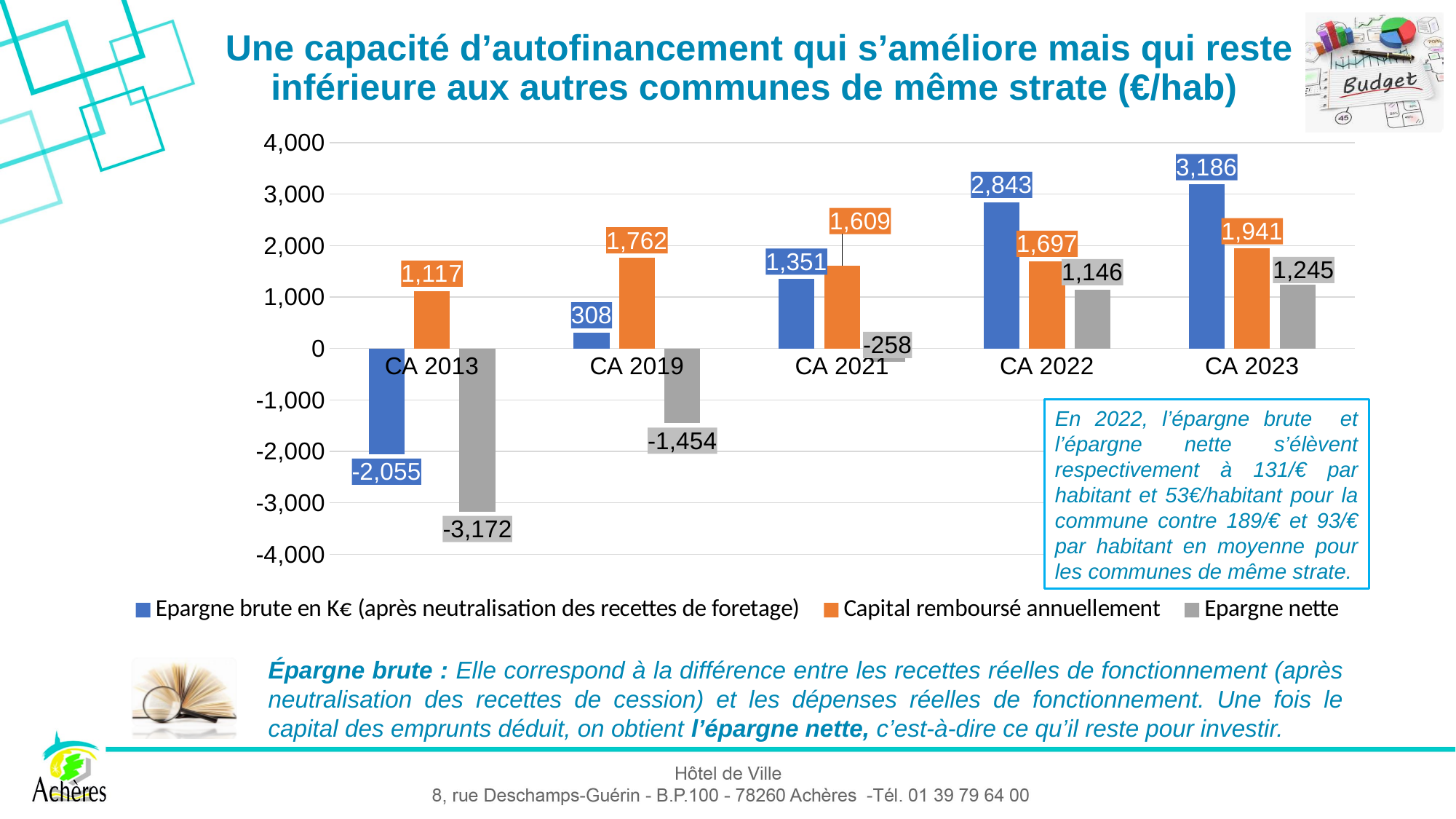
What is the value of Capital remboursé annuellement for CA 2019? 1,762 What kind of chart is shown on the slide? Bar chart Which is larger for CA 2021: Epargne brute en K€ or Capital remboursé annuellement? Capital remboursé annuellement What is the value of Epargne nette for CA 2021? -258 What is the difference between Epargne brute en K€ for CA 2023 and CA 2022? 343 How many series does the legend list? 3 What is the value of Epargne brute en K€ for CA 2023? 3,186 How many categories are shown on the x axis? 5 Which category has the lowest value for Epargne nette? CA 2013 Which category has the highest value for Epargne brute en K€? CA 2023 Does Epargne brute en K€ rise or fall from CA 2013 to CA 2023? Rise What is the value of Epargne nette for CA 2013? -3,172